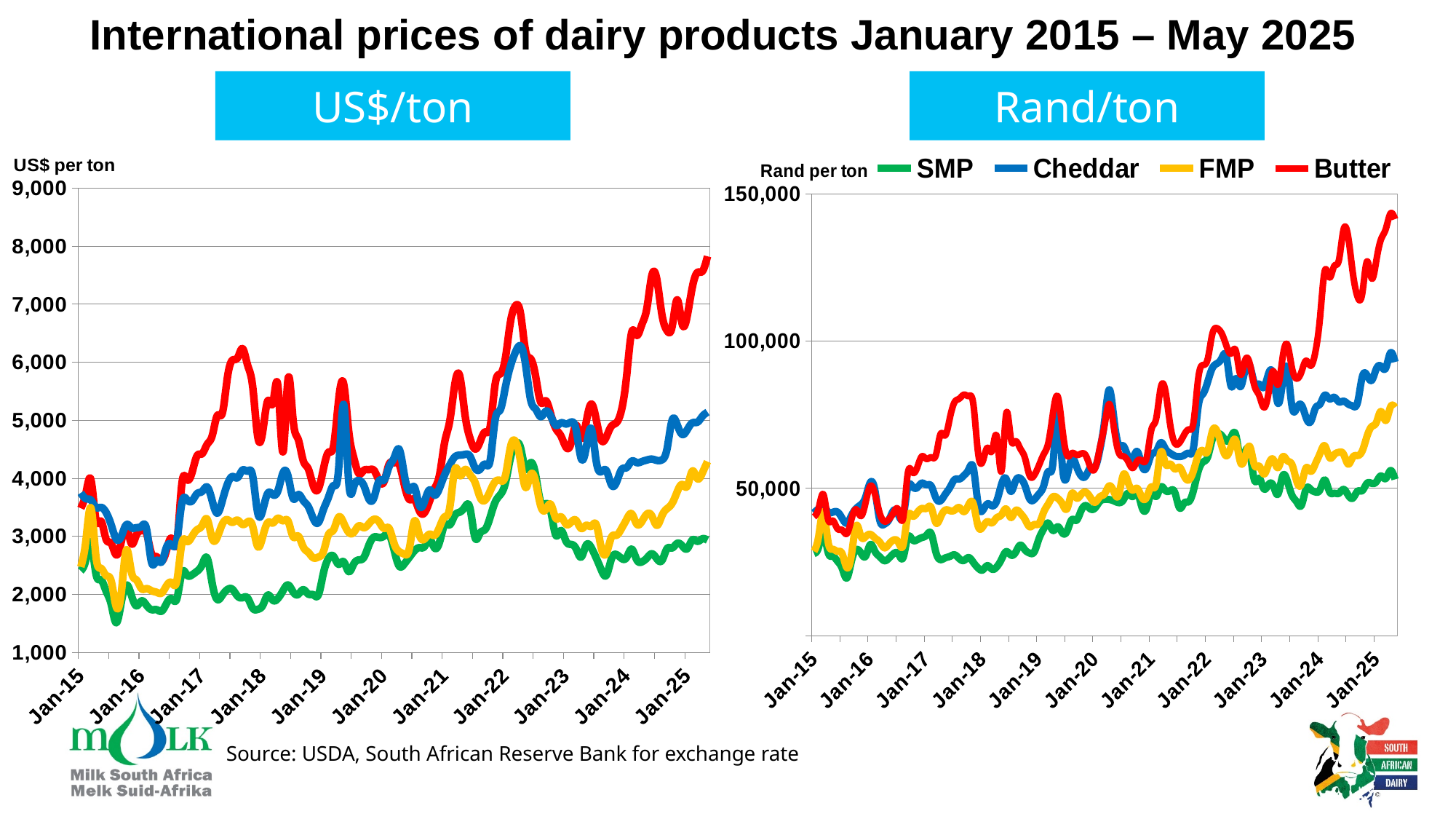
On the US$/ton chart, is the FMP value at the end of the series (2025) greater or less than 5,000? less On the Rand/ton chart, does the Butter price overall rise or fall from Jan-15 to 2025? rise How many series does the legend on the Rand/ton chart list? 4 Which series is shown in red on the Rand/ton chart? Butter On the US$/ton chart, is the Butter value at the end of the series (2025) greater or less than 7,000? greater On the Rand/ton chart, is the Cheddar value at the end of the series (2025) greater or less than 100,000? less What kind of chart is the US$/ton chart? line chart On the US$/ton chart, which series has the higher value at the end of the series (2025), Butter or SMP? Butter On the Rand/ton chart, which series has the lowest value at the end of the series (2025)? SMP